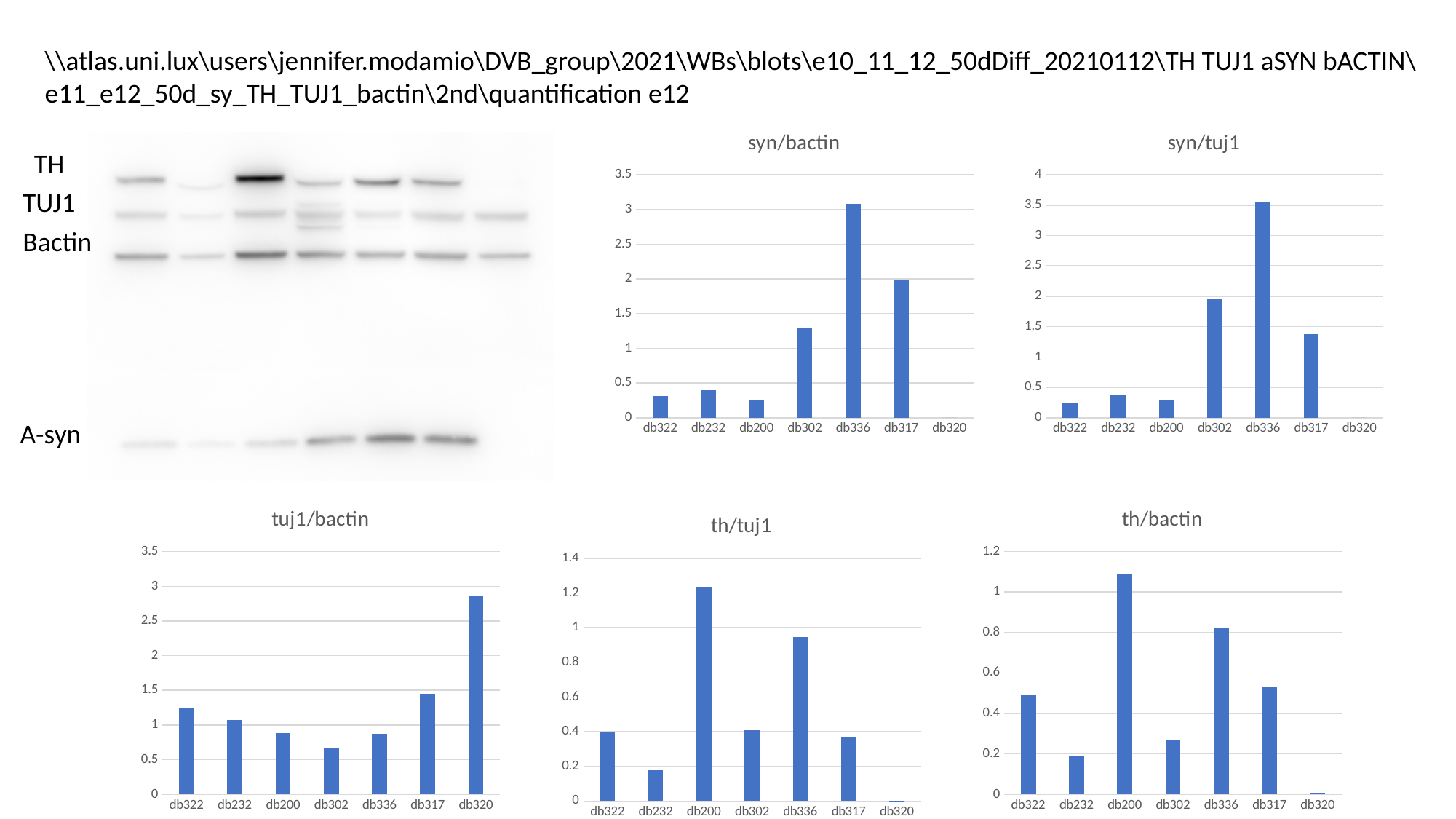
In the syn/bactin chart, which category has the highest value? db336 In the th/tuj1 chart, is the value for db336 greater or less than 0.8? greater In the tuj1/bactin chart, which category has the highest value? db320 In the syn/tuj1 chart, which category has the highest value? db336 In the tuj1/bactin chart, which category has the lowest value? db302 What kind of chart is the th/bactin chart? bar chart In the th/bactin chart, is the value for db200 greater or less than 1? greater How many categories are shown on the x axis of the tuj1/bactin chart? 7 In the syn/bactin chart, is the value for db336 greater or less than 3? greater In the th/bactin chart, which is larger, the value for db336 or the value for db317? db336